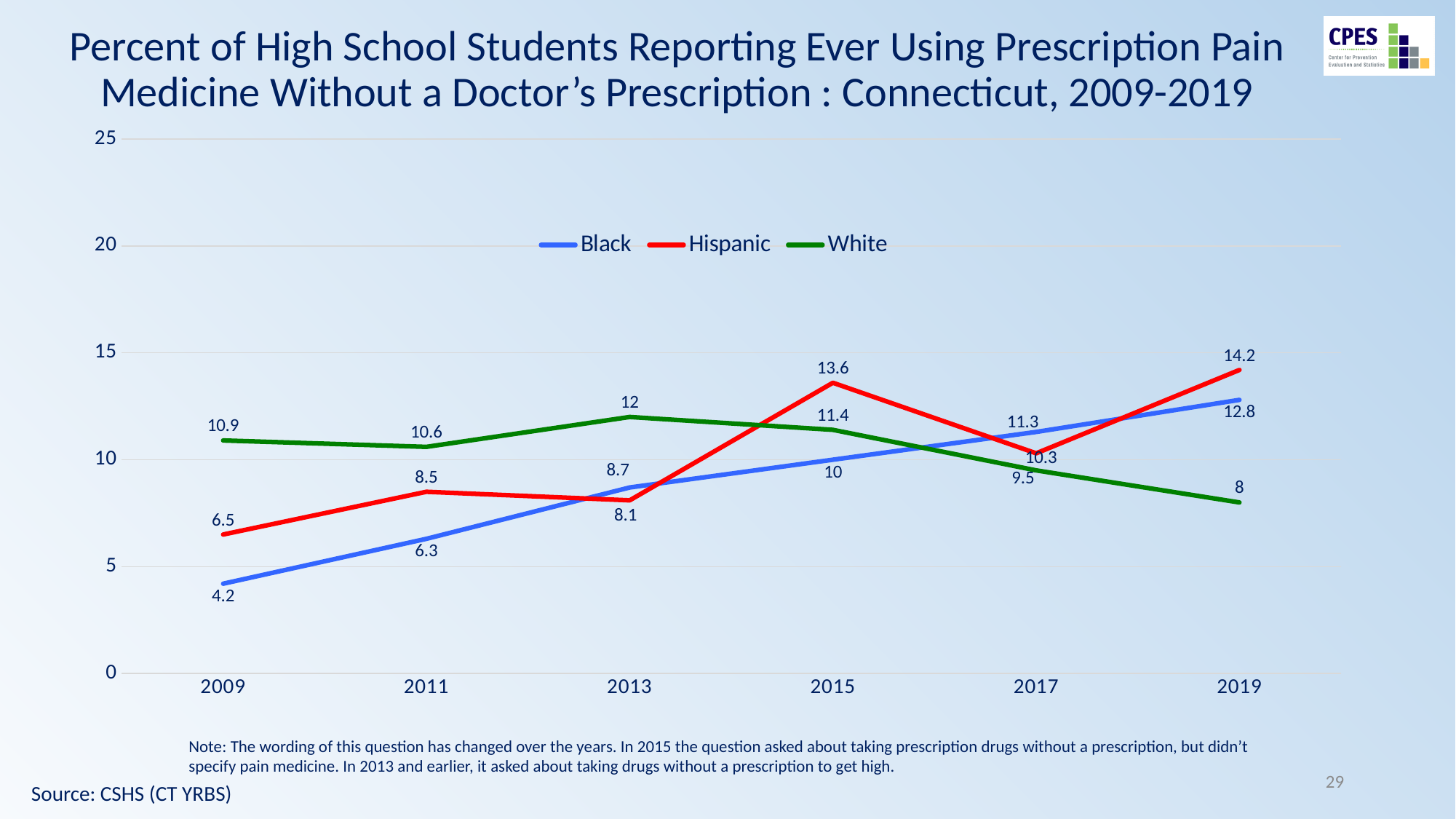
In which year is the White series at its lowest? 2019 What colour is the line for the White series? green What is the value for White students in 2019? 8 What is the value for Black students in 2009? 4.2 Which is larger in 2013, the Black value or the Hispanic value? Black Does the Black series rise or fall from 2009 to 2019? rise What is the difference between the Hispanic and Black values in 2019? 1.4 What is the value for Hispanic students in 2015? 13.6 How many years are plotted along the x axis? 6 What type of chart is shown on the slide? line chart In which year is the Hispanic series at its highest? 2019 How many series does the legend list? 3